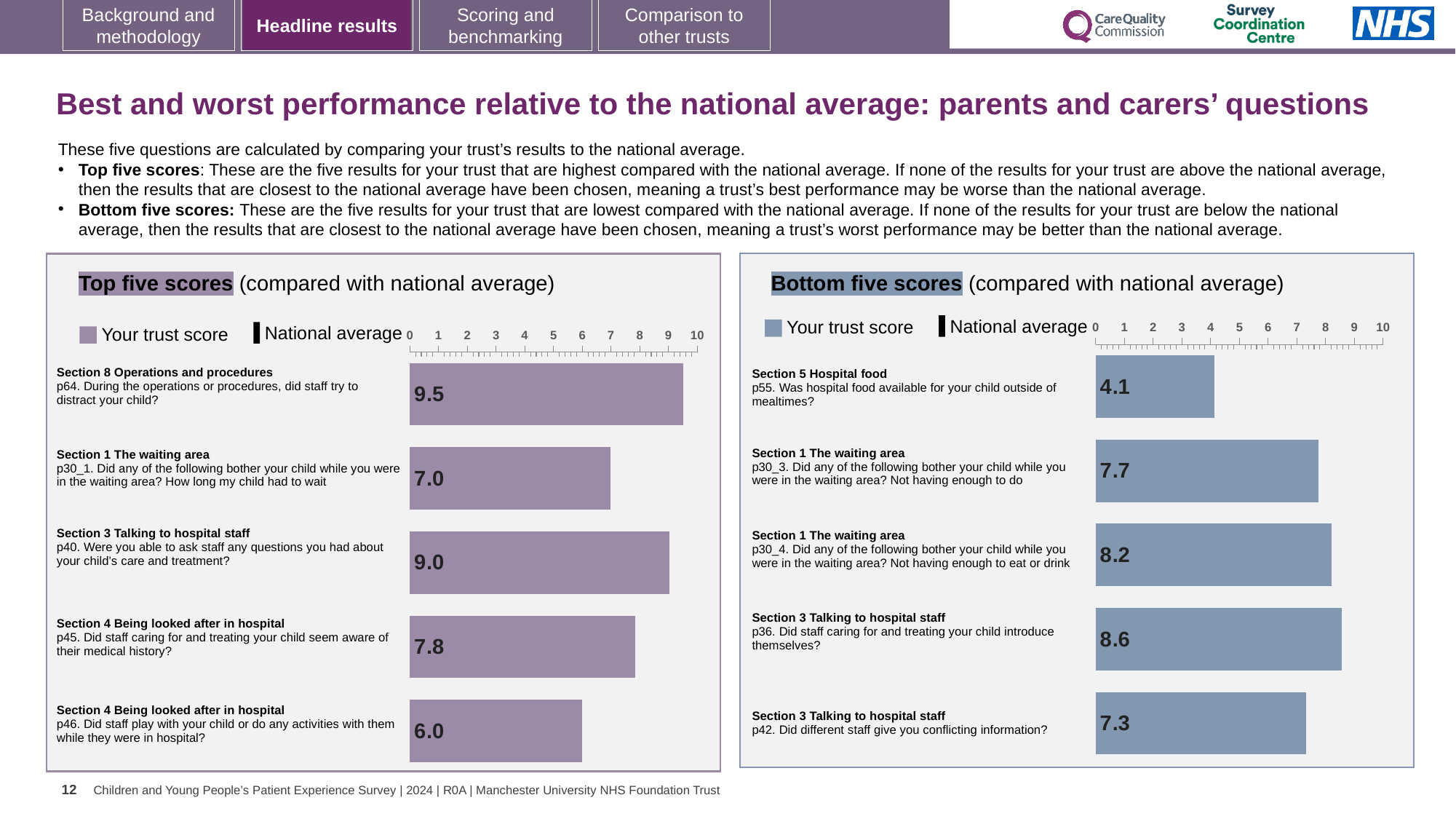
In the Bottom five scores chart, what is the difference between the trust scores for p36 and p55? 4.5 In the Top five scores chart, which has a higher trust score: p40 or p45? p40 How many bars are shown in the Bottom five scores chart? 5 In the Bottom five scores chart, what is the trust score for p36 (did staff introduce themselves)? 8.6 What type of chart is used for the Top five scores? Bar chart In the Bottom five scores chart, what is the trust score for p55 (was hospital food available outside of mealtimes)? 4.1 In the Bottom five scores chart, which question has the lowest trust score? p55. Was hospital food available for your child outside of mealtimes? In the Top five scores chart, what is the difference between the trust scores for p64 and p46? 3.5 How many series does the legend of the Bottom five scores chart list? 2 In the Top five scores chart, what is the trust score for p64 (did staff try to distract your child during operations or procedures)? 9.5 In the Top five scores chart, which question has the highest trust score? p64. During the operations or procedures, did staff try to distract your child? In the Top five scores chart, what is the trust score for p46 (did staff play with your child or do any activities with them)? 6.0